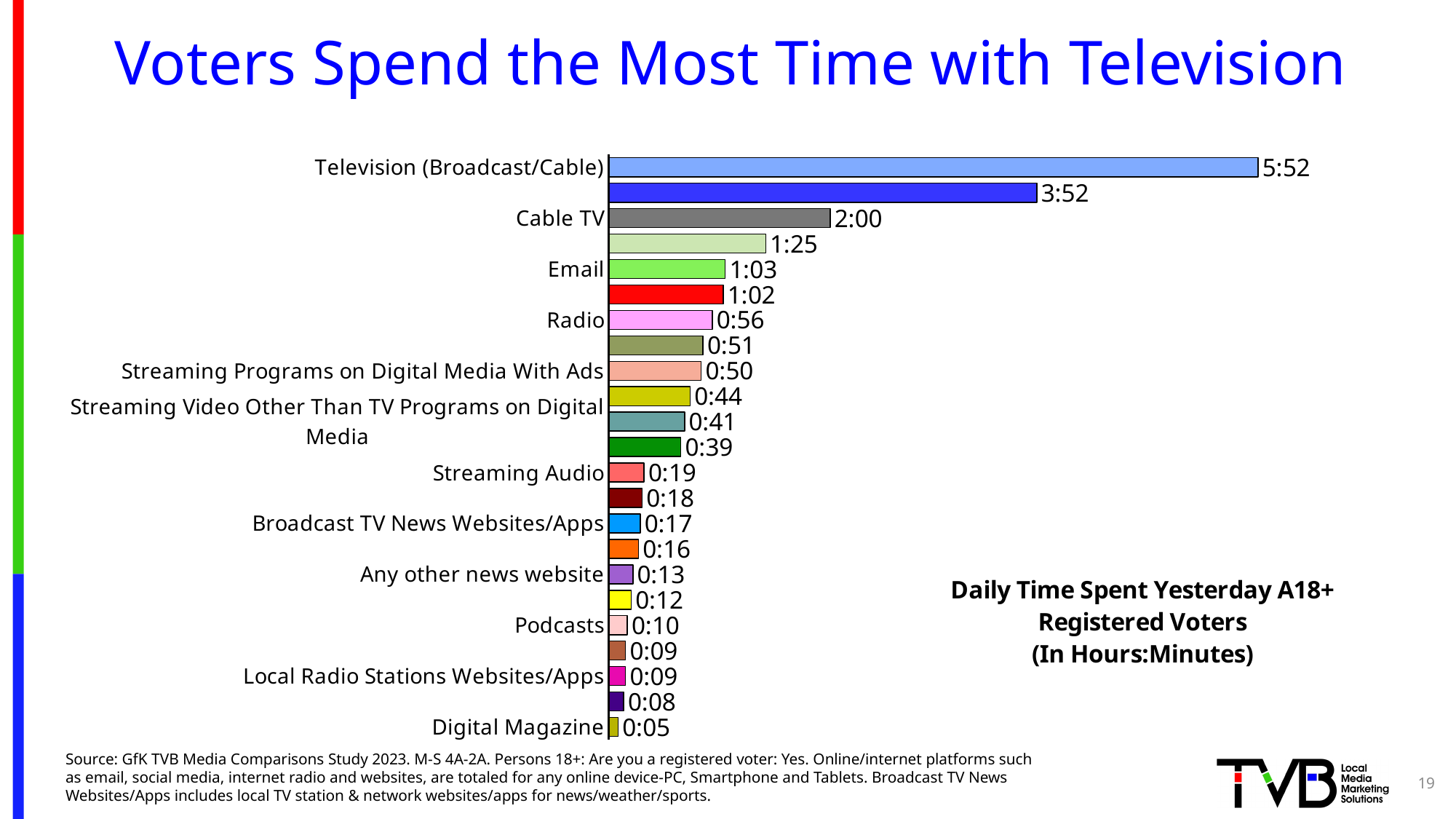
What is the daily time spent with Television (Broadcast/Cable)? 5:52 What is the daily time spent with Streaming Audio? 0:19 What is the daily time spent with Cable TV? 2:00 In what units are the values in the chart expressed, according to the chart's text? Hours:Minutes Which labeled category has the lowest daily time spent? Digital Magazine How much more time is spent with Television (Broadcast/Cable) than with Cable TV? 3:52 What is the daily time spent with Email? 1:03 Which labeled category has the highest daily time spent? Television (Broadcast/Cable) Which has a higher daily time spent, Radio or Broadcast TV News Websites/Apps? Radio What kind of chart is shown on the slide? Bar chart How many bars are plotted in the chart? 23 What is the daily time spent with Podcasts? 0:10